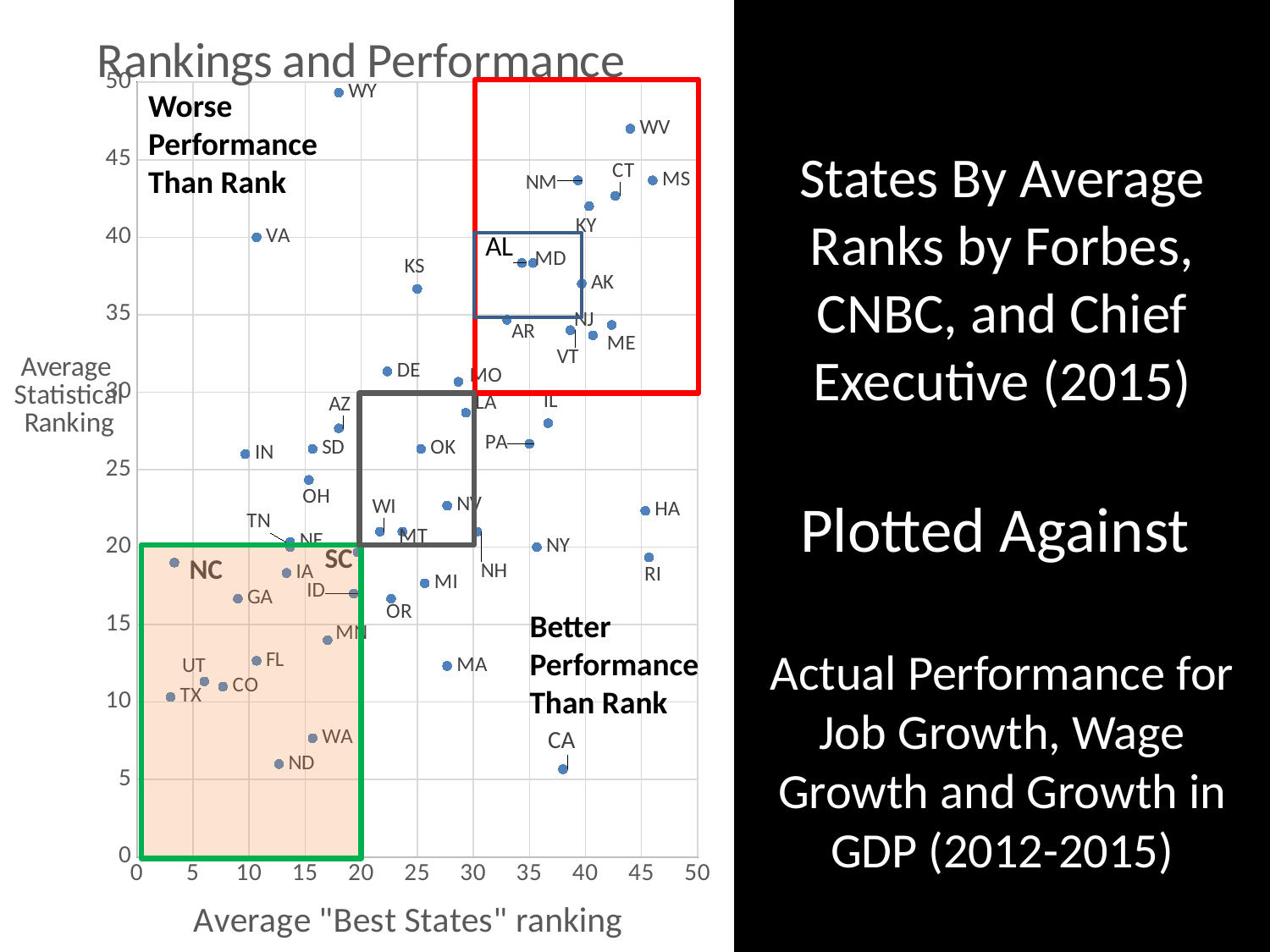
Is the Average "Best States" ranking value for HA greater or less than 40? greater Which state has the highest Average Statistical Ranking value on the chart? WY Is the Average Statistical Ranking value for WY greater or less than 45? greater Is the Average Statistical Ranking value for CA greater or less than 10? less What is the label of the x axis of the chart? Average "Best States" ranking What kind of chart is shown on the slide? scatter plot Which state has the larger Average "Best States" ranking value, HA or NC? HA What is the title of the chart? Rankings and Performance Which state has the higher Average Statistical Ranking, WY or CA? WY